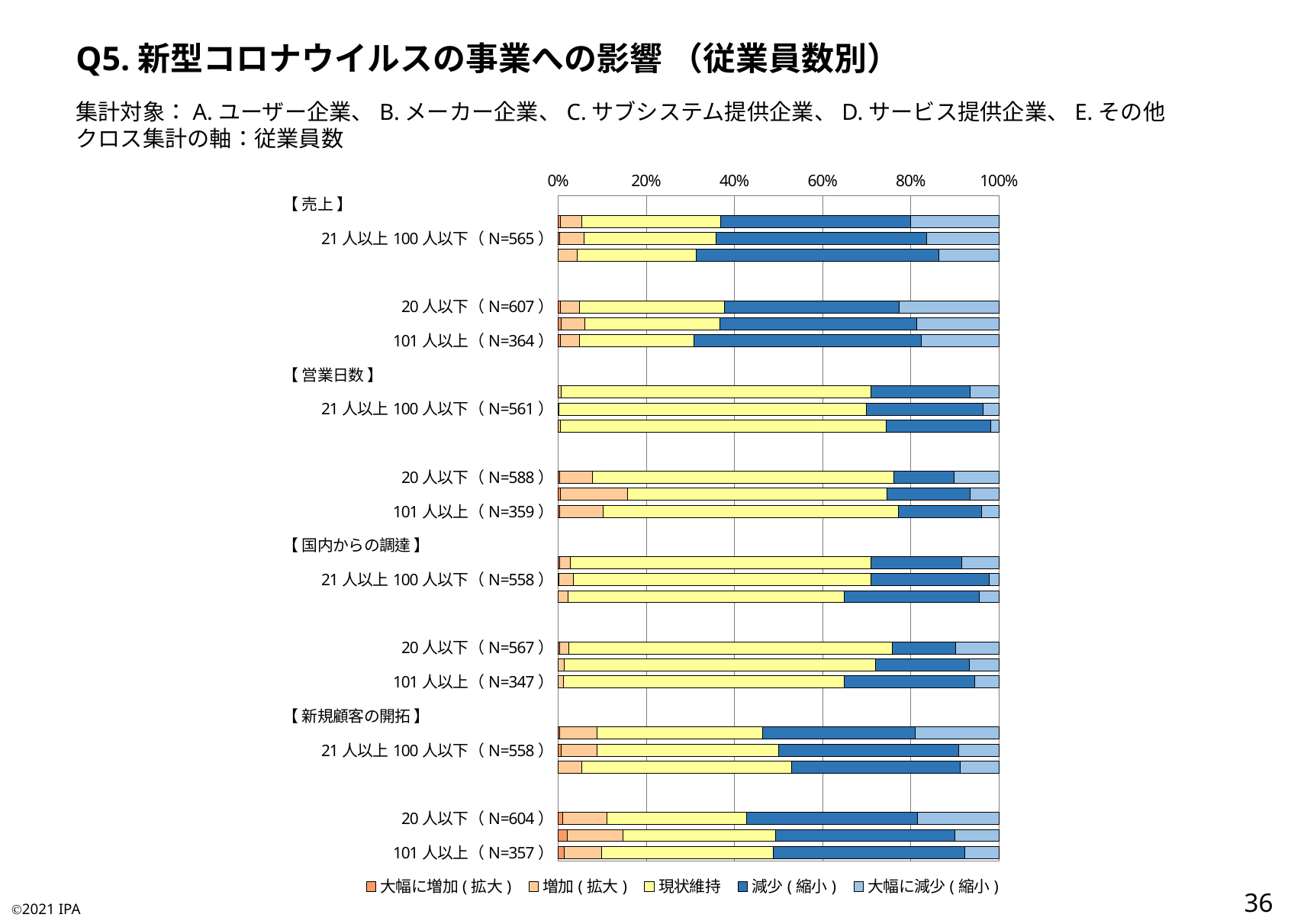
Which section has the larger 減少(縮小) segments, 【売上】 or 【営業日数】? 【売上】 How many bracketed section headings (e.g. 【売上】) are shown along the chart's category axis? 4 What is the N value printed for 21人以上100人以下 in the 【売上】 section? N=565 What kind of chart is shown on the slide? stacked bar chart Which section has the larger 現状維持 segments, 【国内からの調達】 or 【新規顧客の開拓】? 【国内からの調達】 What is the last entry in the chart legend? 大幅に減少(縮小) What is the N value printed for 101人以上 in the 【営業日数】 section? N=359 What is the maximum value shown on the horizontal axis? 100% In the 【売上】 section, is the 現状維持 share of each bar greater or less than 40%? less In the 【営業日数】 section, is the 現状維持 share of each bar greater or less than 60%? greater What is the N value printed for 20人以下 in the 【新規顧客の開拓】 section? N=604 How many series does the legend list? 5